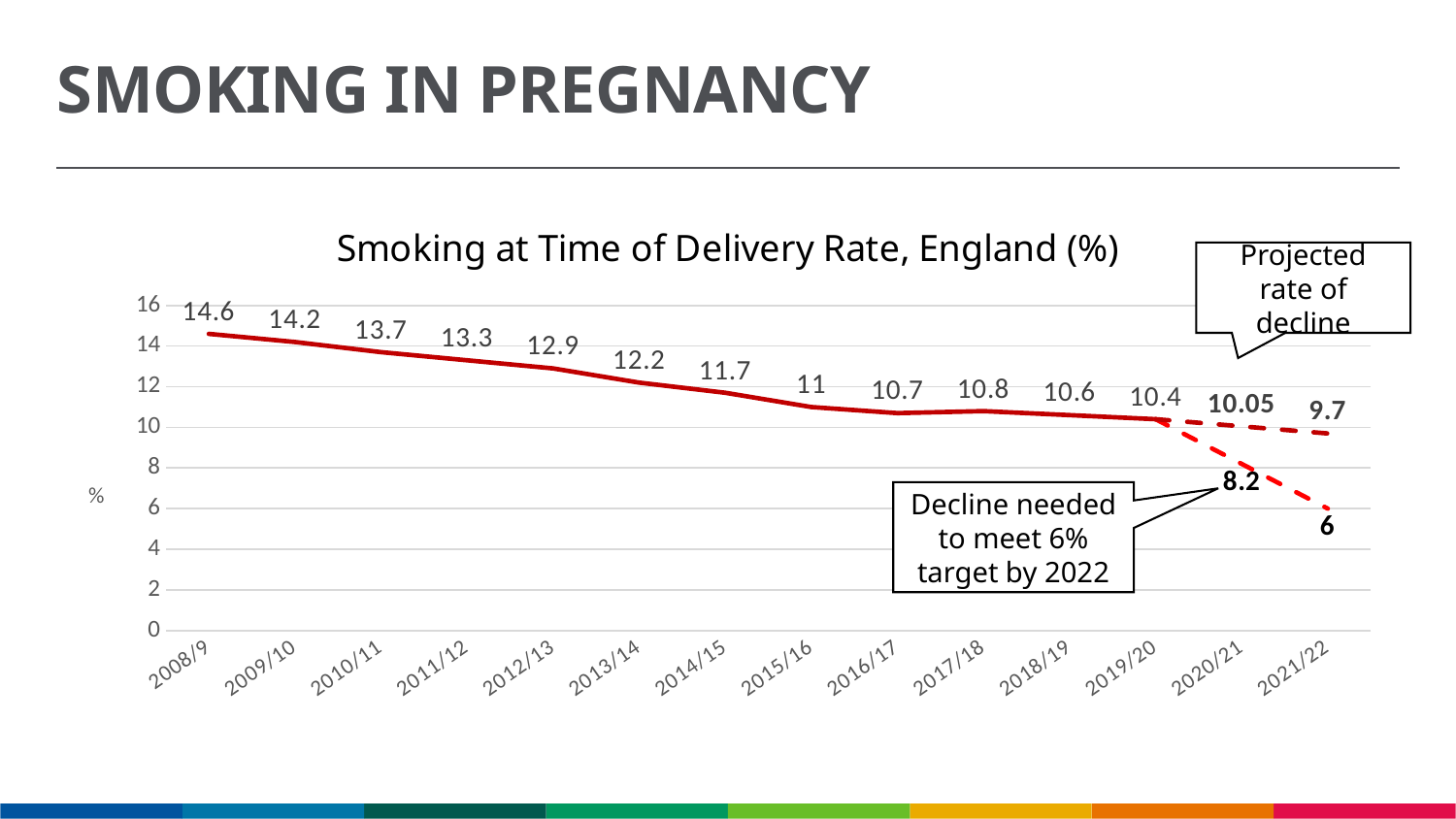
Is the value for 2012/13 greater or less than 12? greater How many years are shown on the x axis? 14 Which is larger, the rate for 2016/17 or the rate for 2017/18? 2017/18 Which year has the lowest value on the solid (actual) line? 2019/20 What is the difference between the 2008/9 rate and the 2019/20 rate? 4.2 What is the projected rate of decline value shown for 2021/22? 9.7 What is the smoking at time of delivery rate for 2008/9? 14.6 What is the smoking at time of delivery rate for 2015/16? 11 What value is shown for 2021/22 on the 'Decline needed to meet 6% target by 2022' line? 6 Which year has the highest smoking at time of delivery rate on the solid line? 2008/9 What kind of chart is shown on the slide? Line chart Do the values on the solid line generally rise or fall from 2008/9 to 2019/20? Fall